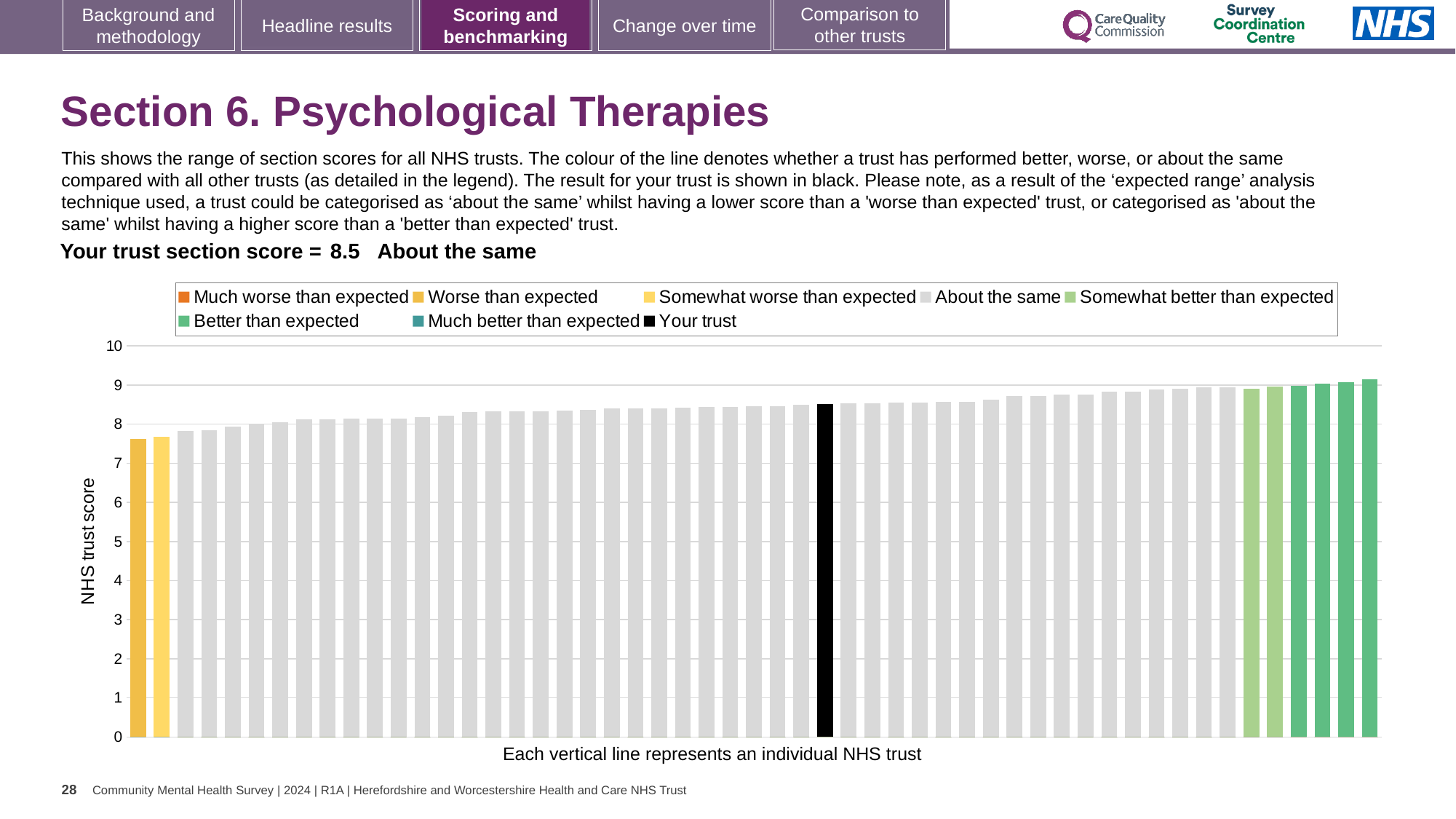
Which legend category do the tallest bars in the chart belong to? Better than expected What kind of chart is shown on the slide? bar chart What is the label on the vertical axis of the chart? NHS trust score Is the value for Your trust (the black bar) greater or less than 8? greater Is the value for the rightmost bar in the chart greater or less than 8? greater How many entries does the chart legend list? 8 Is the black bar for Your trust higher or lower than the leftmost yellow bar? higher How many bars are coloured yellow (Worse than expected) in the chart? 1 What is the section score for your trust shown on the slide? 8.5 Which performance category is your trust placed in for this section? About the same Do the bar values rise or fall from left to right along the x axis? rise Is the value for the leftmost bar in the chart greater or less than 8? less